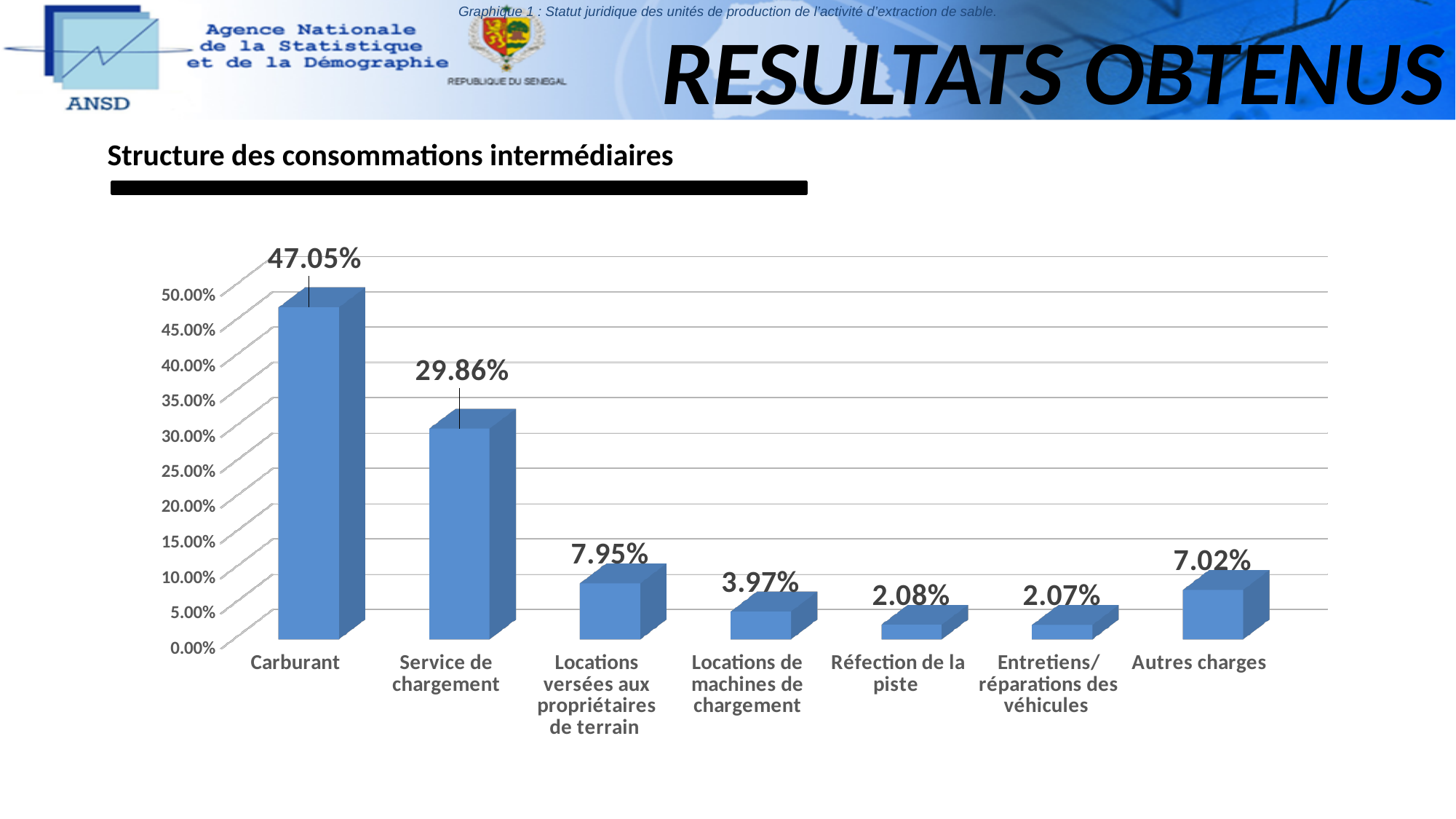
What is the value for Carburant? 47.05% What is the value for Service de chargement? 29.86% How many categories are shown in the chart? 7 What is the difference between the values for Carburant and Service de chargement? 17.19% Which is larger, Locations versées aux propriétaires de terrain or Autres charges? Locations versées aux propriétaires de terrain What is the value for Locations de machines de chargement? 3.97% What is the title of the chart? Structure des consommations intermédiaires Which category has the highest value? Carburant Which category has the lowest value? Entretiens/réparations des véhicules What is the difference between the values for Réfection de la piste and Entretiens/réparations des véhicules? 0.01% What kind of chart is shown on the slide? Bar chart What is the value for Autres charges? 7.02%